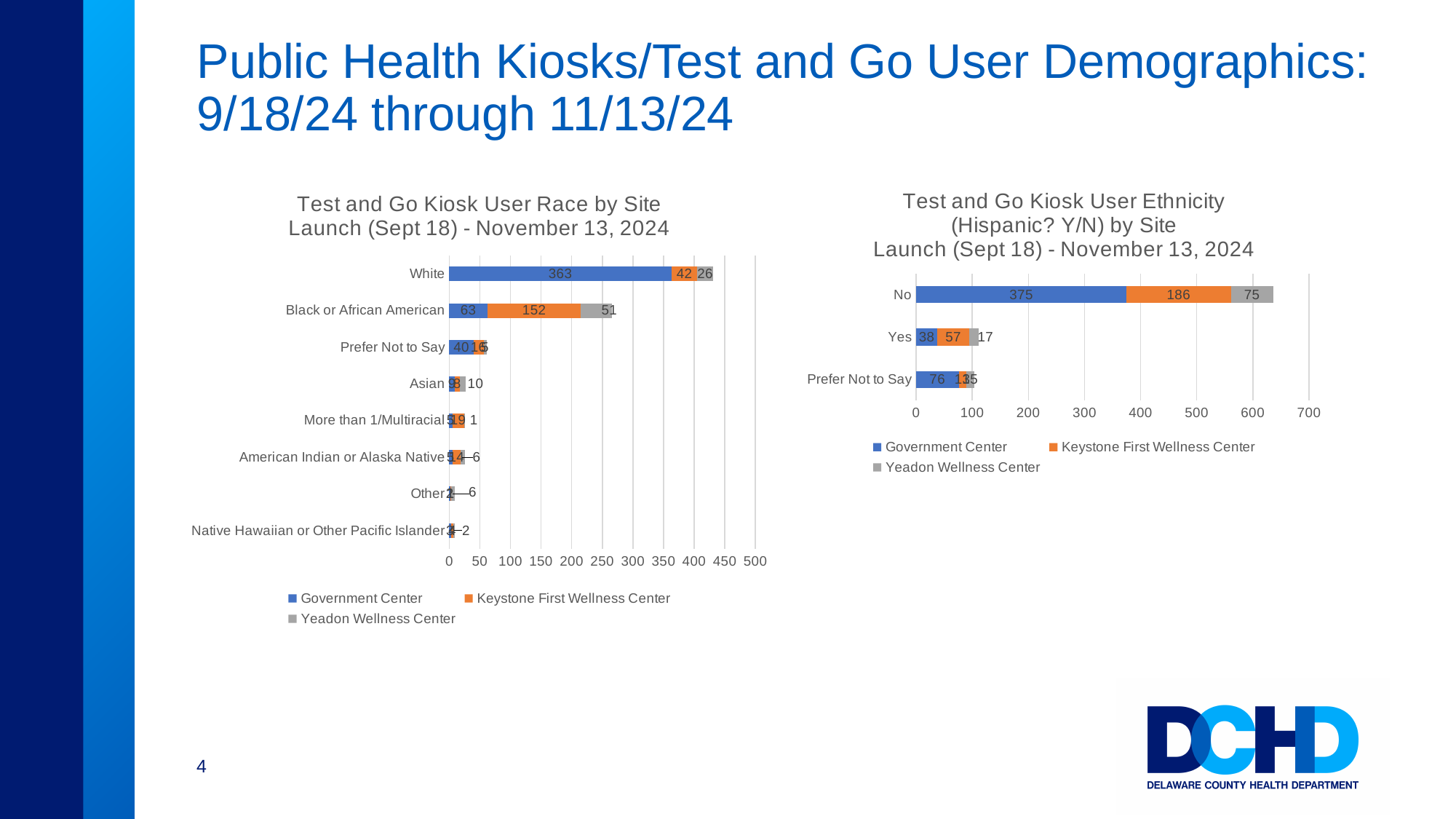
In the Test and Go Kiosk User Race by Site chart, which race category has the longest stacked bar? White In the Test and Go Kiosk User Race by Site chart, what is the Government Center value for White? 363 In the Test and Go Kiosk User Ethnicity chart, what is the difference between the Government Center and Keystone First Wellness Center values for No? 189 In the Test and Go Kiosk User Race by Site chart, what is the Keystone First Wellness Center value for Black or African American? 152 In the Test and Go Kiosk User Race by Site chart, how many race categories are shown? 8 In the Test and Go Kiosk User Race by Site chart, for Black or African American, which is larger: the Government Center value or the Keystone First Wellness Center value? Keystone First Wellness Center In the Test and Go Kiosk User Race by Site chart, what is the total of the stacked bar for White? 431 What kind of chart is the Test and Go Kiosk User Ethnicity chart? Stacked bar chart How many series does the legend of the Test and Go Kiosk User Ethnicity chart list? 3 In the Test and Go Kiosk User Race by Site chart, what is the total of the stacked bar for Black or African American? 266 In the Test and Go Kiosk User Ethnicity chart, what is the total of the stacked bar for Yes? 112 In the Test and Go Kiosk User Ethnicity chart, what is the Government Center value for No? 375